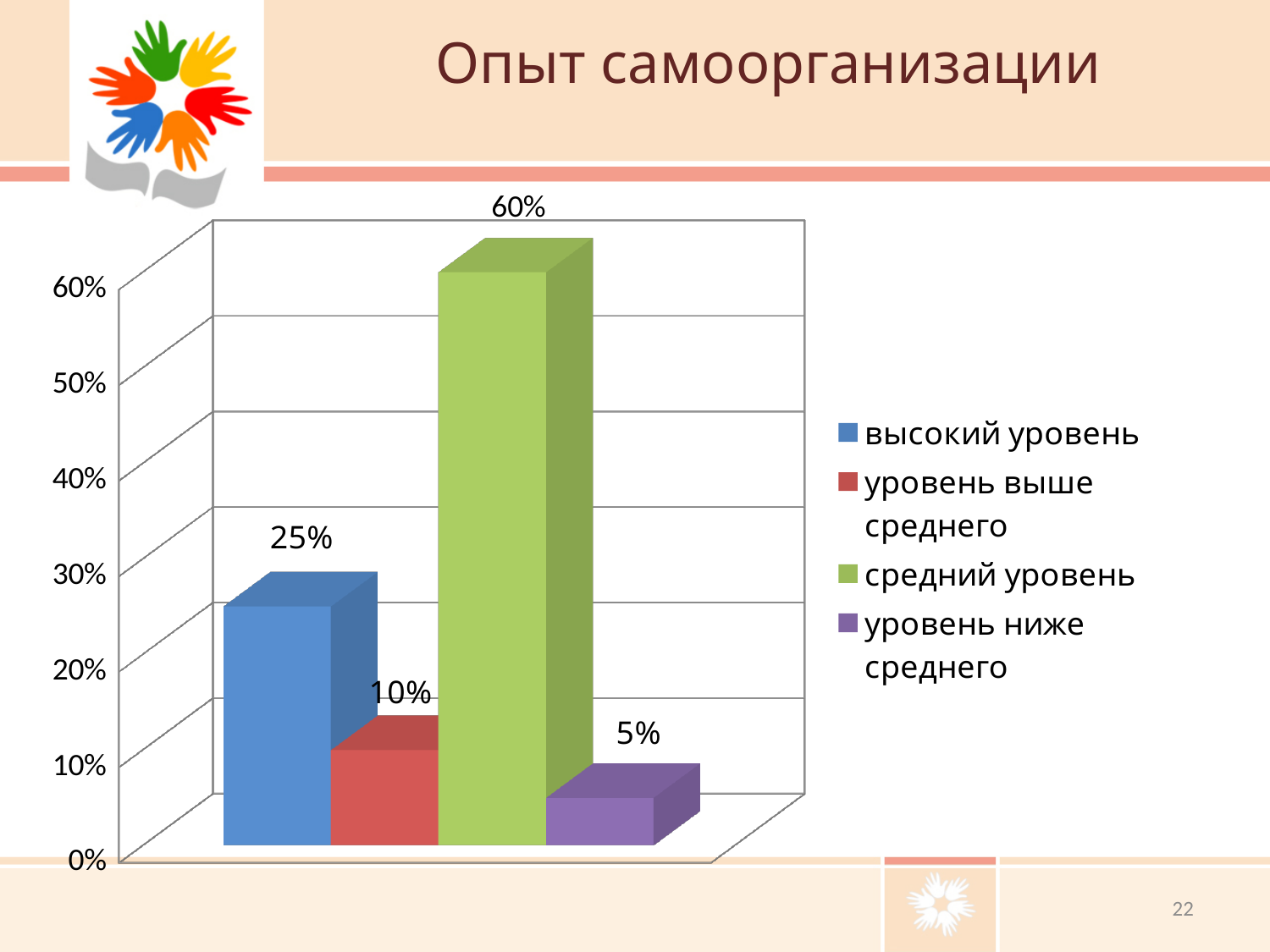
What is the value for высокий уровень? 25% Which is larger, the value for высокий уровень or the value for уровень выше среднего? высокий уровень Which series has the highest value? средний уровень What is the difference between the values for средний уровень and высокий уровень? 35% What is the difference between the values for уровень выше среднего and уровень ниже среднего? 5% What kind of chart is shown on the slide? bar chart How many series does the legend list? 4 Which series has the lowest value? уровень ниже среднего What is the value for уровень выше среднего? 10% What is the value for средний уровень? 60% What is the title of the slide containing the chart? Опыт самоорганизации What is the value for уровень ниже среднего? 5%